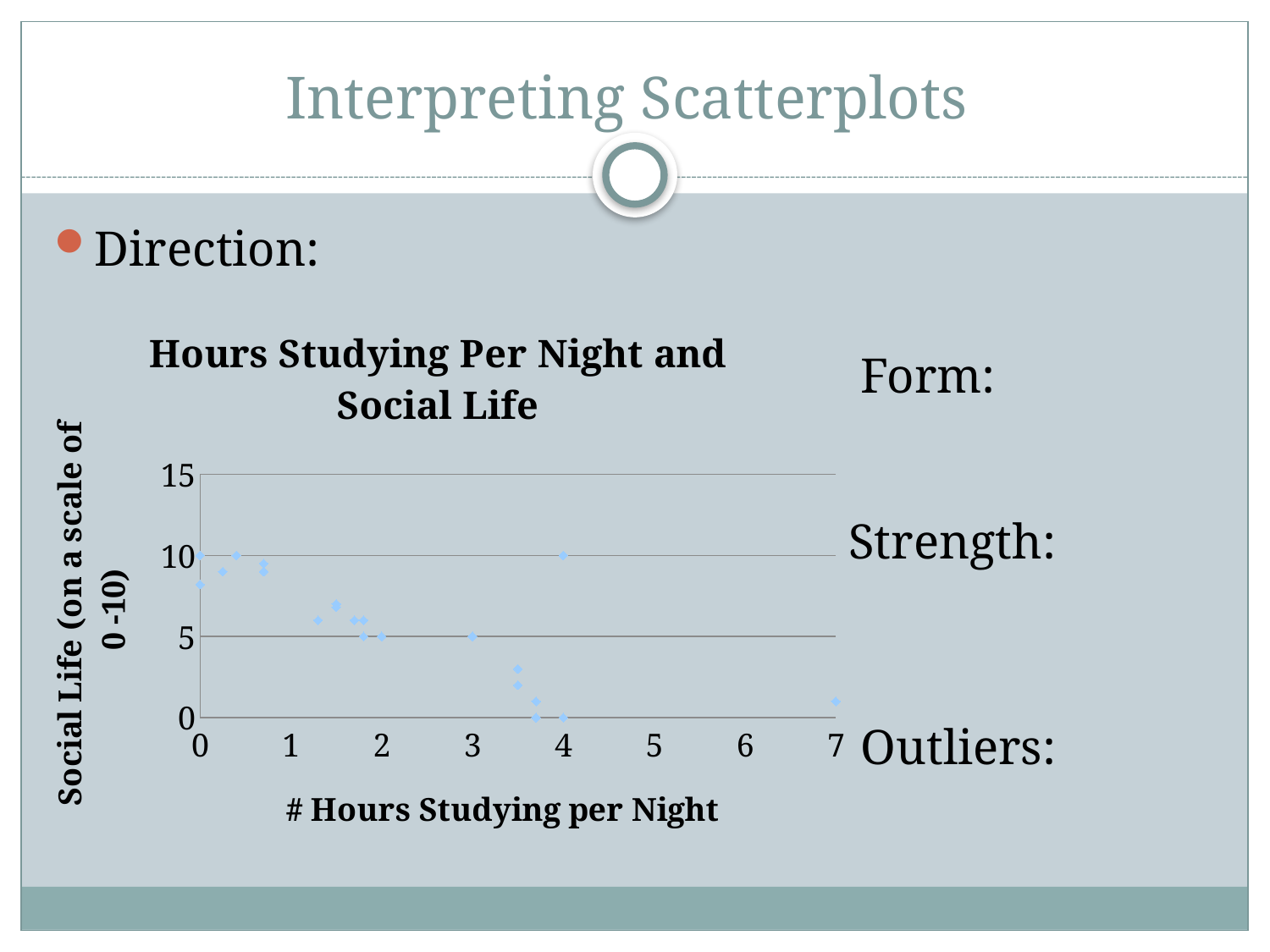
What is the label of the x axis of the chart? # Hours Studying per Night What is the highest value shown on the y axis of the chart? 15 What kind of chart is shown on the slide? scatter plot Is the social life value for the point at 1.5 hours studying per night greater or less than 10? less As the number of hours studying per night increases, do the social life values generally rise or fall? fall What is the title of the chart? Hours Studying Per Night and Social Life Which has the larger social life value: the point at 0.4 hours studying or the point at 3.5 hours studying? the point at 0.4 hours Is the social life value for the point at 0.4 hours studying per night greater or less than 5? greater Is the social life value for the point at 7 hours studying per night greater or less than 5? less